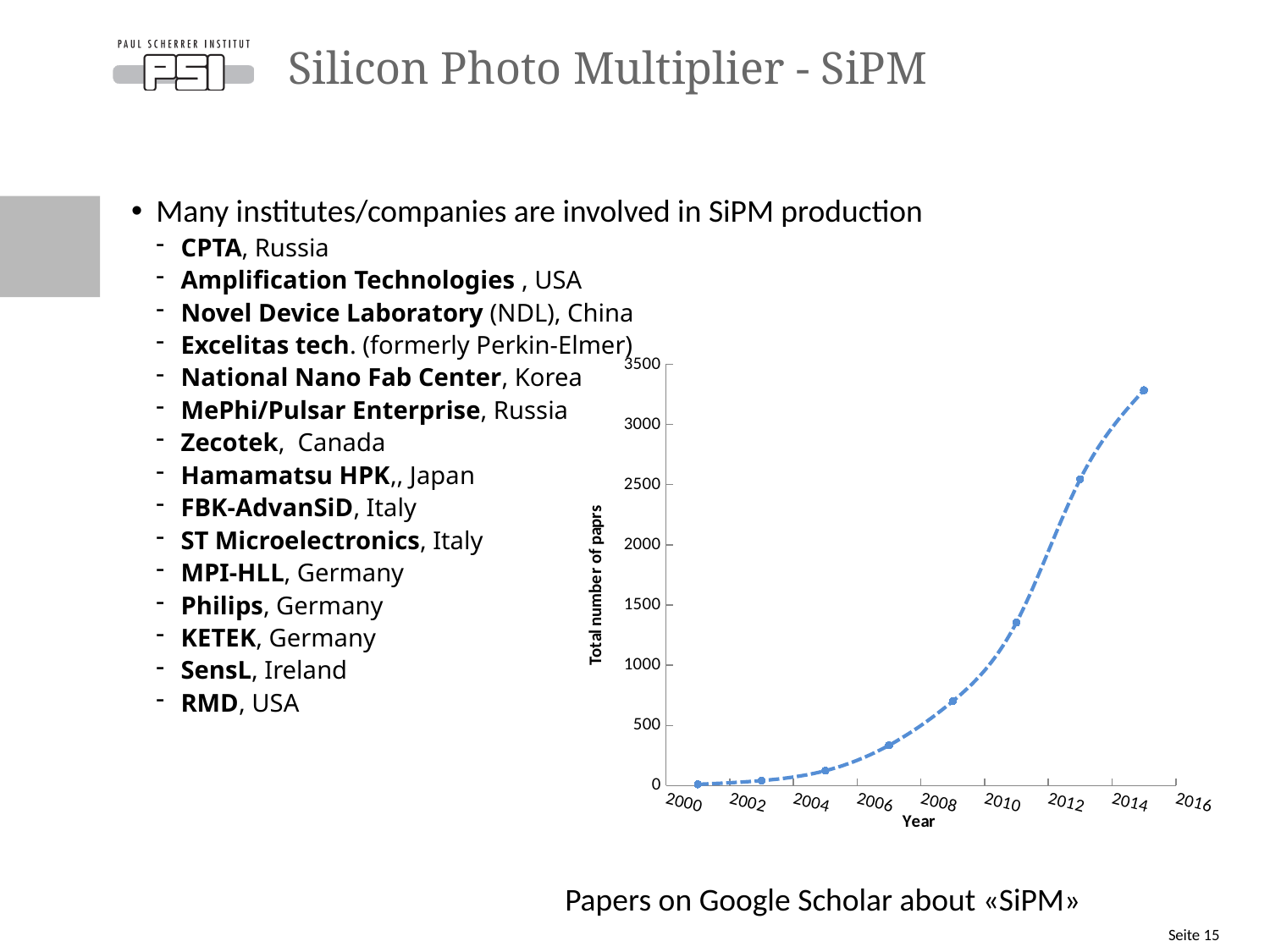
What is the label of the vertical axis of the chart? Total number of paprs Do the values in the chart rise or fall as the year increases? rise What is the label of the horizontal axis of the chart? Year Is the value of the data point just after 2012 greater or less than 2000? greater Which data point has the highest value, the first one or the last one? the last one What kind of chart is shown on the slide? line chart Is the value of the data point just after 2006 greater or less than 500? less What is the maximum value shown on the vertical axis of the chart? 3500 Is the value of the data point just after 2010 greater or less than 1500? less How many data points are plotted in the chart? 8